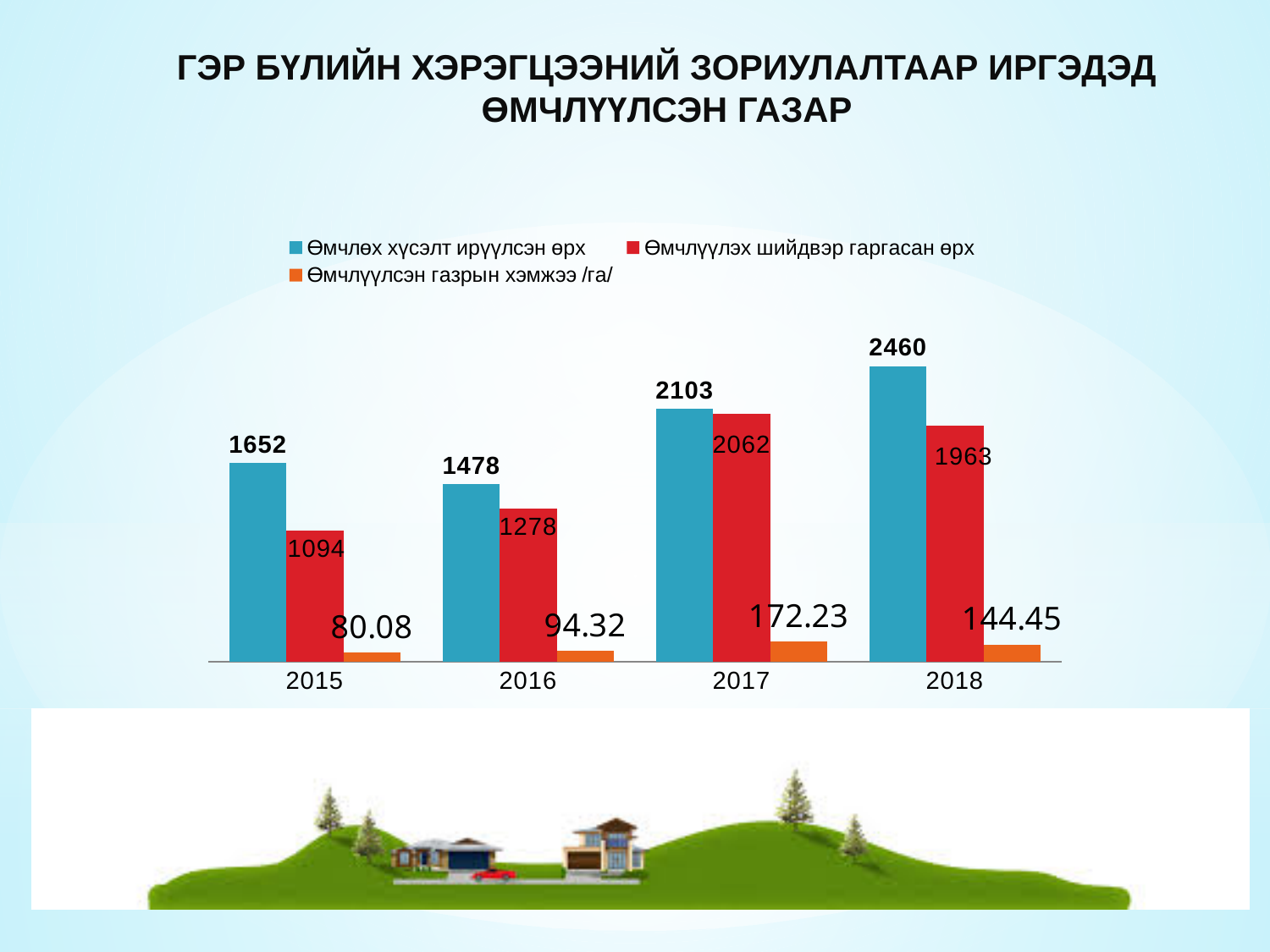
What is the difference between Өмчлөх хүсэлт ирүүлсэн өрх and Өмчлүүлэх шийдвэр гаргасан өрх in 2015? 558 What is the value of Өмчлүүлэх шийдвэр гаргасан өрх in 2016? 1278 How many years are shown on the x axis? 4 In which year is Өмчлүүлсэн газрын хэмжээ /га/ the highest? 2017 What type of chart is shown on the slide? bar chart How many series does the legend list? 3 What colour are the bars for Өмчлүүлсэн газрын хэмжээ /га/? orange Does Өмчлүүлэх шийдвэр гаргасан өрх rise or fall from 2017 to 2018? fall In which year is Өмчлөх хүсэлт ирүүлсэн өрх the lowest? 2016 Which is larger in 2017: Өмчлөх хүсэлт ирүүлсэн өрх or Өмчлүүлэх шийдвэр гаргасан өрх? Өмчлөх хүсэлт ирүүлсэн өрх What is the value of Өмчлүүлсэн газрын хэмжээ /га/ in 2017? 172.23 What is the value of Өмчлөх хүсэлт ирүүлсэн өрх in 2018? 2460